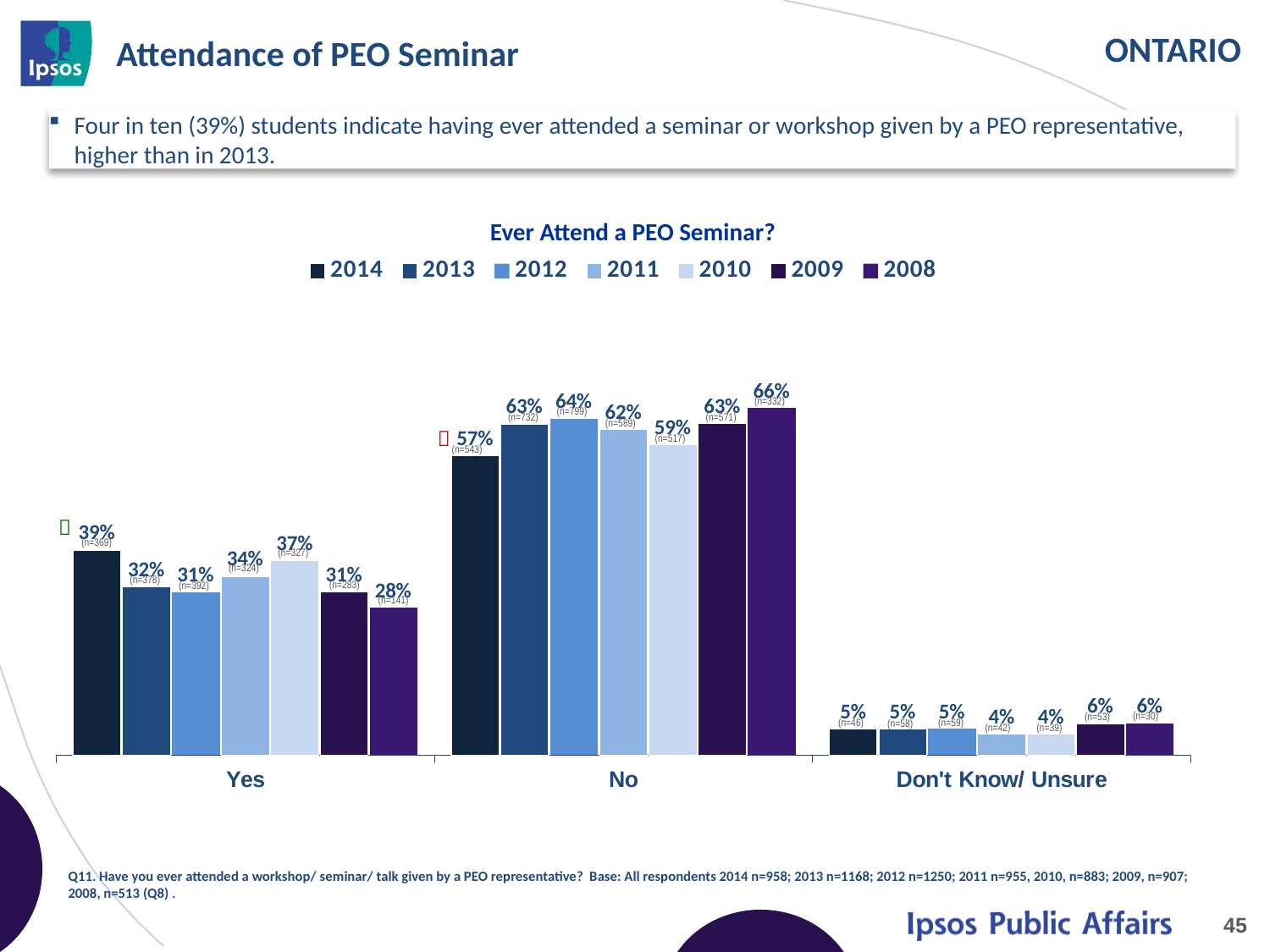
Which year has the lowest value in the No category? 2014 What is the title of the chart? Ever Attend a PEO Seminar? What type of chart is shown on the slide? Bar chart What is the difference between the 2014 and 2013 values in the Yes category? 7 percentage points How many response categories are shown on the x axis? 3 How many series does the legend list? 7 Which year has the highest value in the Yes category? 2014 What is the value for 2008 in the No category? 66% Which is larger: the 2010 value for Yes or the 2011 value for Yes? 2010 What is the value for 2011 in the Don't Know/ Unsure category? 4% Which year has the lowest value in the Yes category? 2008 What percentage of students in 2014 said Yes to ever attending a PEO seminar? 39%